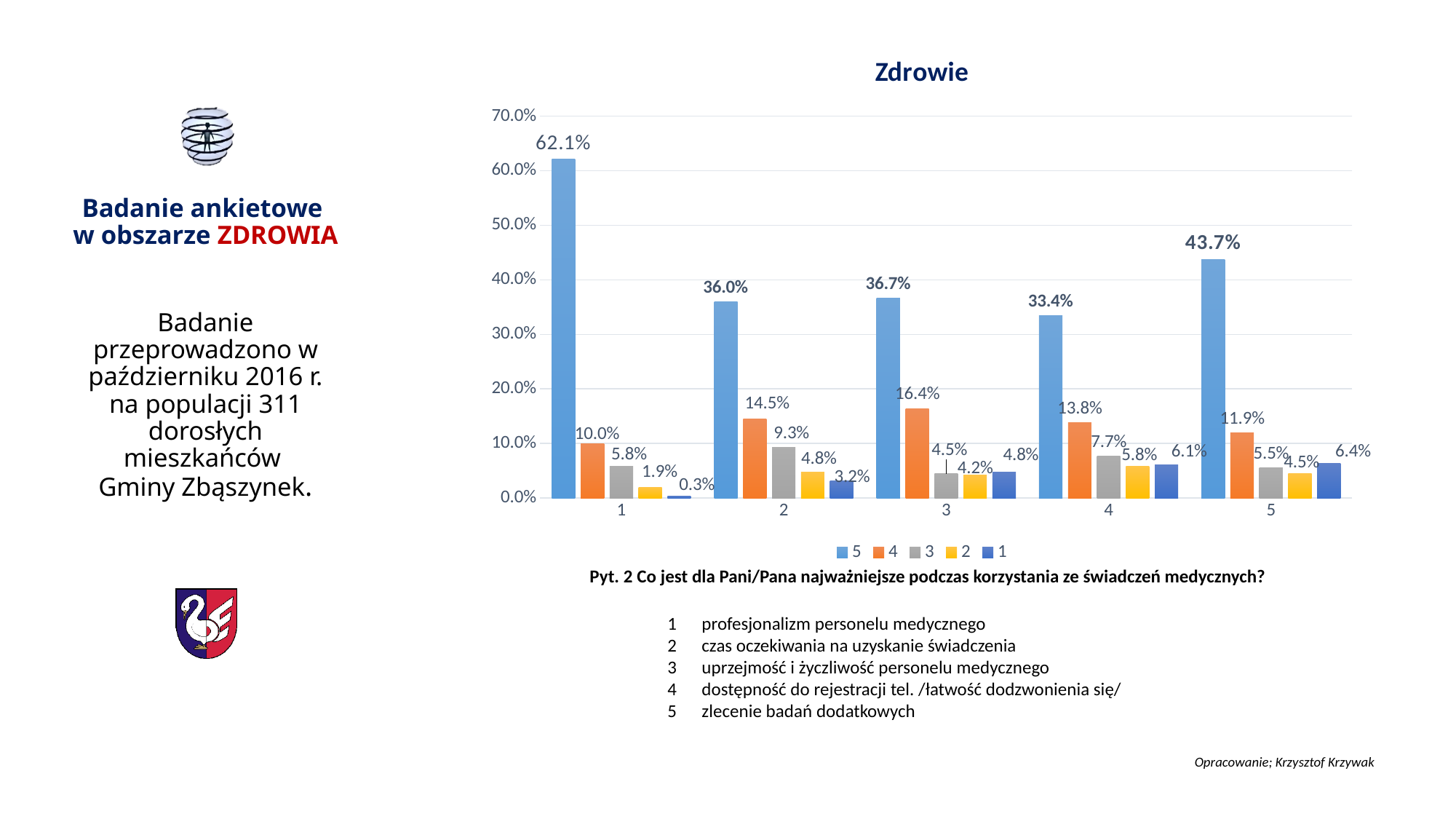
Which category has the lowest value for series 1? 1 What is the value of series 5 for category 1? 62.1% What is the difference between the series 5 values for category 1 and category 5? 18.4% How many series does the legend list? 5 Which is larger: the series 4 value for category 2 or for category 4? category 2 What is the value of series 4 for category 3? 16.4% What type of chart is shown on the slide? bar chart What is the value of series 1 for category 5? 6.4% Which category has the highest value for series 5? 1 Is the series 5 value for category 5 greater or less than 40.0%? greater How many categories are shown on the x axis? 5 What is the value of series 3 for category 2? 9.3%